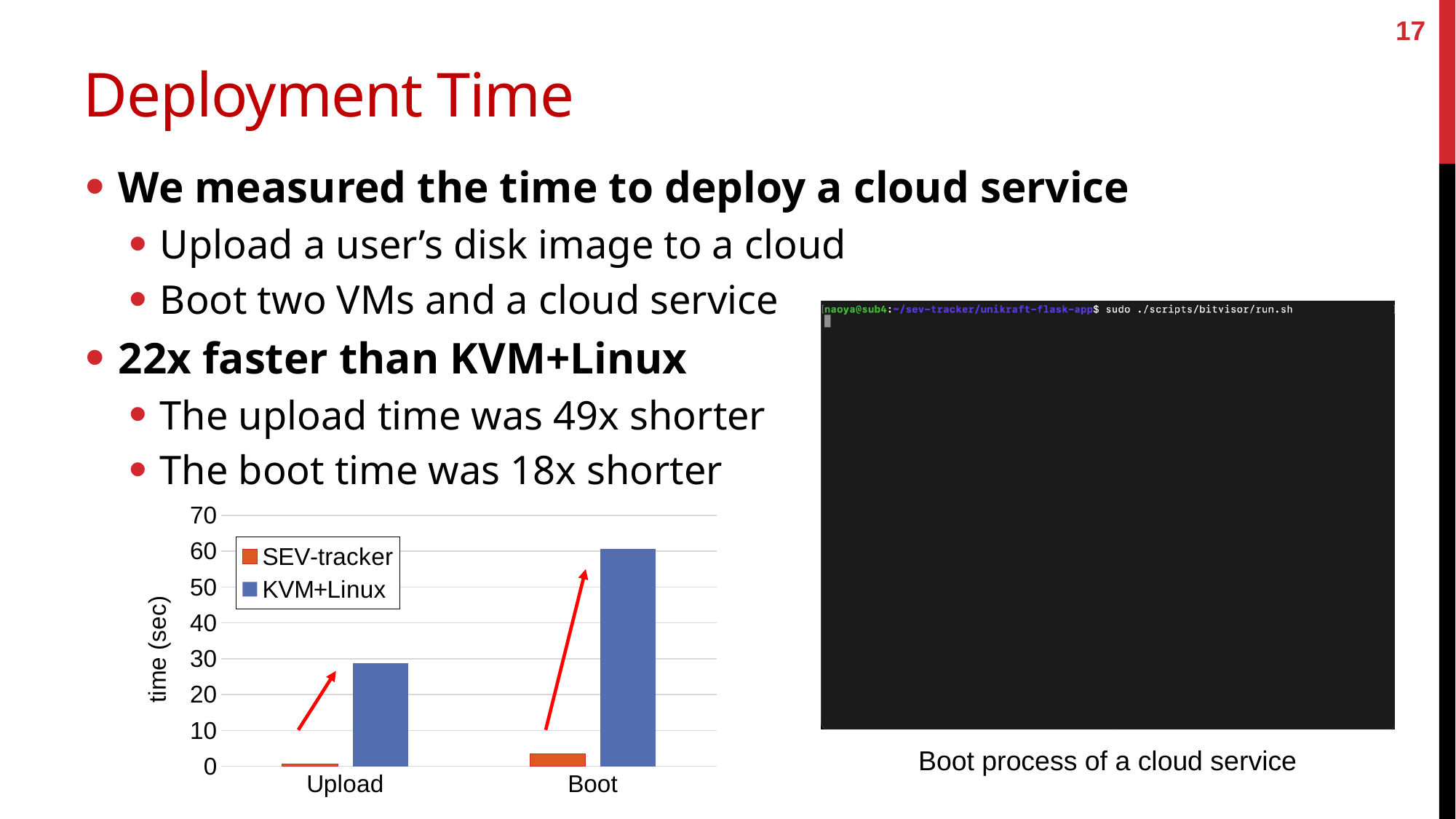
How many categories are shown on the x axis of the chart? 2 What is the label of the y axis of the chart? time (sec) Is the KVM+Linux value for Upload greater or less than 40? less How many series does the chart legend list? 2 Which category has the higher KVM+Linux value, Upload or Boot? Boot Which series has the higher value for Upload, SEV-tracker or KVM+Linux? KVM+Linux Is the SEV-tracker value for Boot greater or less than 10? less Which bar in the chart is the tallest? KVM+Linux for Boot Is the KVM+Linux value for Upload greater or less than 20? greater Which series is shown in blue in the chart? KVM+Linux What kind of chart is shown on the slide? bar chart